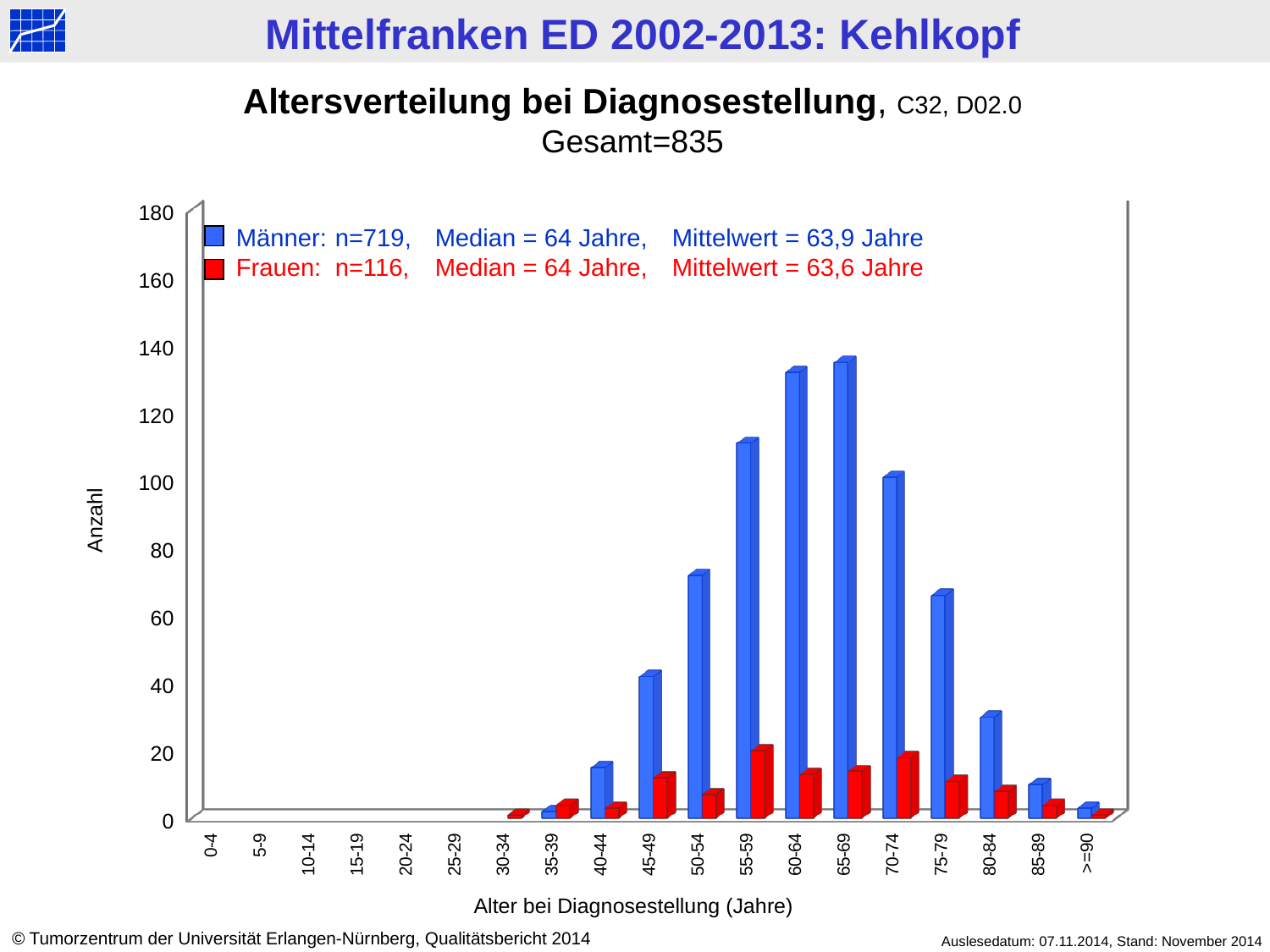
Is the value for Frauen in the 55-59 age group greater or less than 40? less Is the value for Männer in the 50-54 age group greater or less than 80? less What is the Mittelwert for Frauen given in the legend? 63,6 Jahre How many series does the legend list? 2 Do the Männer values rise or fall from the 70-74 age group to the >=90 age group? fall According to the legend, what is n for Männer? 719 Is the value for Männer in the 80-84 age group greater or less than 40? less Which is larger for Männer: the 70-74 age group or the 75-79 age group? 70-74 Which is larger for Männer: the 50-54 age group or the 55-59 age group? 55-59 How many age categories are shown on the x axis? 19 What kind of chart is shown on the slide? bar chart